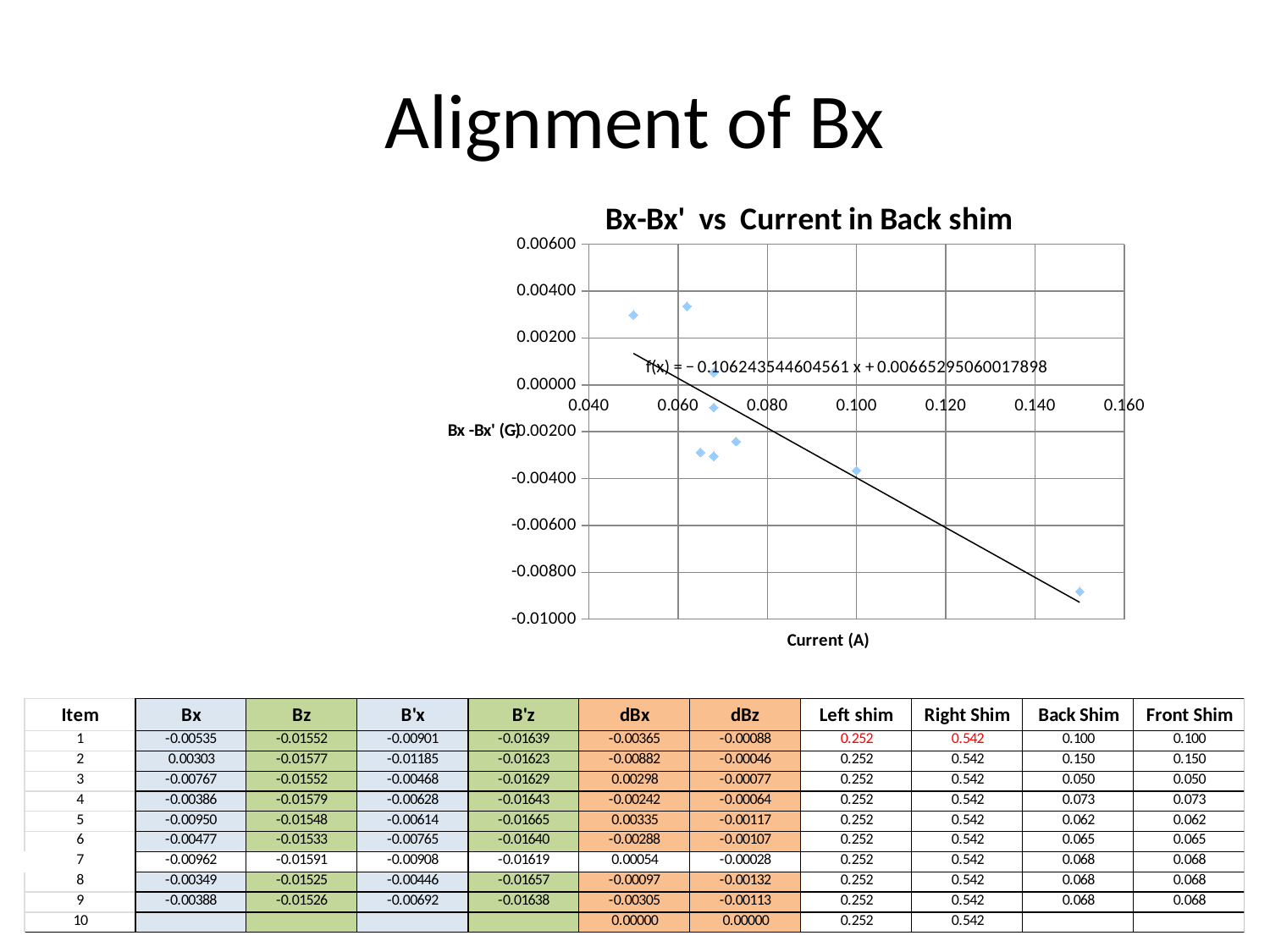
How many data points are plotted in the chart? 9 Is the value of the data point at about 0.100 A greater or less than -0.00200? less Is the value of the data point at the highest current (around 0.150 A) greater or less than -0.00800? less Is the value of the data point at about 0.050 A greater or less than 0.00200? greater What is the lowest value shown on the y axis of the chart? -0.01000 Do the plotted values generally rise or fall as the current increases along the x axis? Fall What kind of chart is shown on the slide? Scatter chart What is the label of the x axis of the chart? Current (A) Which data point has the lowest Bx-Bx' value: the one at about 0.100 A or the one at about 0.150 A? The one at about 0.150 A What is the title of the chart? Bx-Bx' vs Current in Back shim